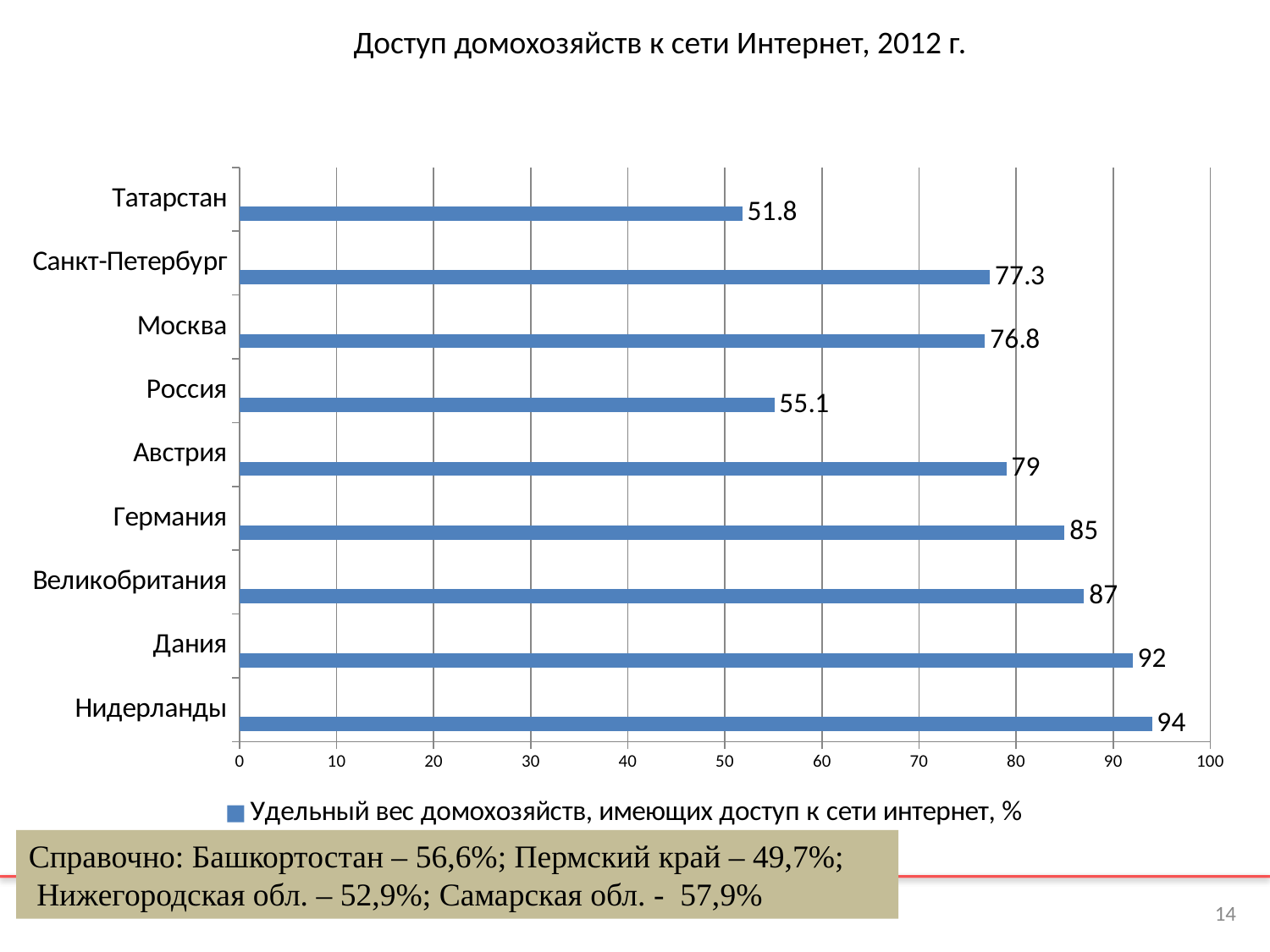
What is the value for Россия? 55.1 Is the value for Великобритания greater or less than 80? greater Which is larger, the value for Санкт-Петербург or the value for Москва? Санкт-Петербург How many series does the legend list? 1 What is the title of the chart? Доступ домохозяйств к сети Интернет, 2012 г. What is the value for Татарстан? 51.8 Which category has the lowest value? Татарстан How many categories are shown in the chart? 9 What kind of chart is shown on the slide? bar chart What is the value for Германия? 85 What is the difference between the values for Дания and Австрия? 13 Which category has the highest value? Нидерланды